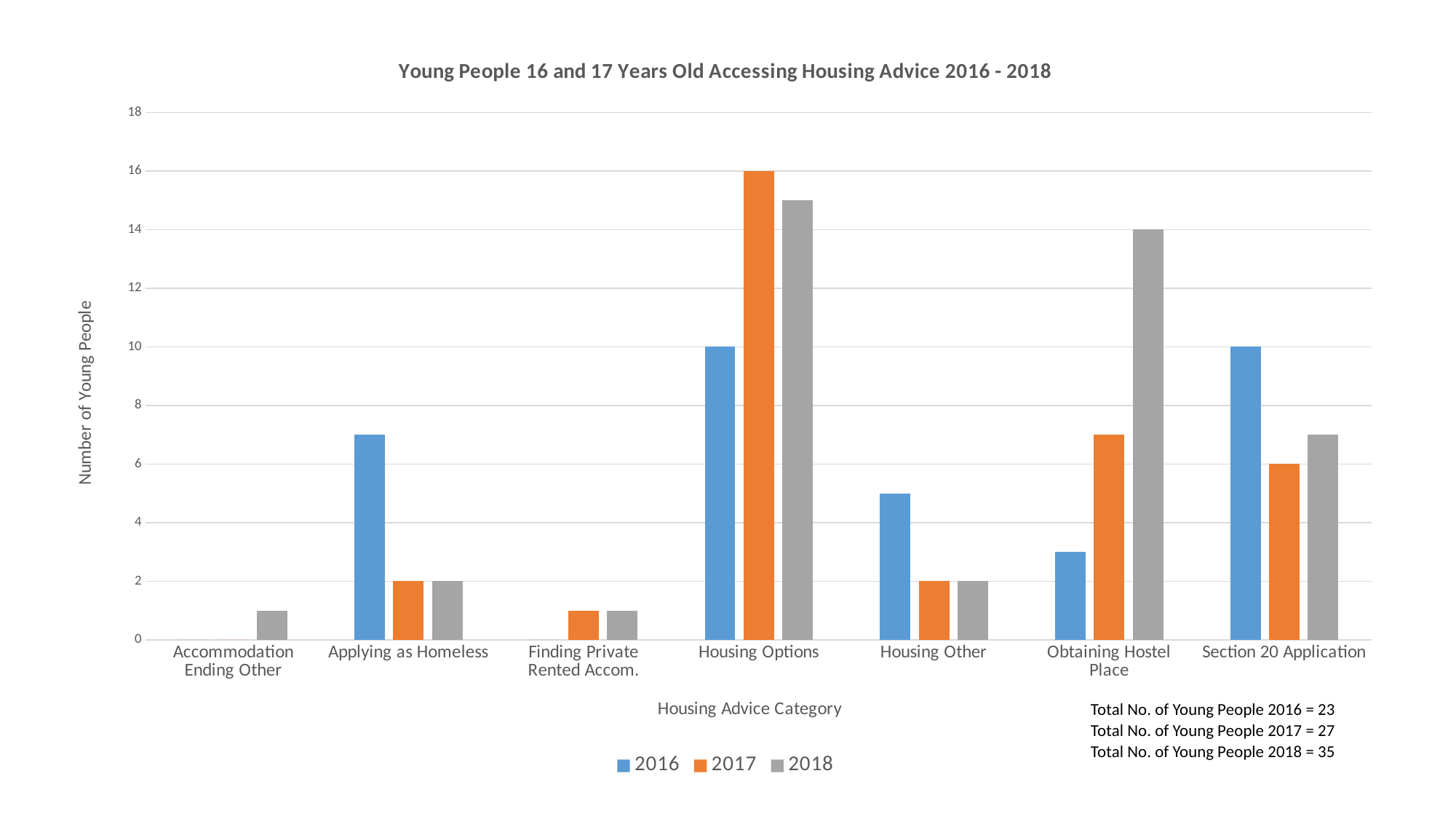
What is the value for Housing Options in 2017? 16 Which is larger for Obtaining Hostel Place: the 2017 value or the 2018 value? 2018 Which category has the highest value for 2016? Housing Options and Section 20 Application (tied at 10) What kind of chart is shown on the slide? bar chart Is the value for Housing Options in 2018 greater or less than 14? greater What is the difference between the 2017 value for Housing Options and the 2017 value for Section 20 Application? 10 What is the value for Obtaining Hostel Place in 2018? 14 Is the value for Applying as Homeless in 2016 greater or less than 6? greater What is the value for Section 20 Application in 2016? 10 How many housing advice categories are shown on the x axis? 7 Which category has the highest value for 2017? Housing Options How many series does the legend list? 3